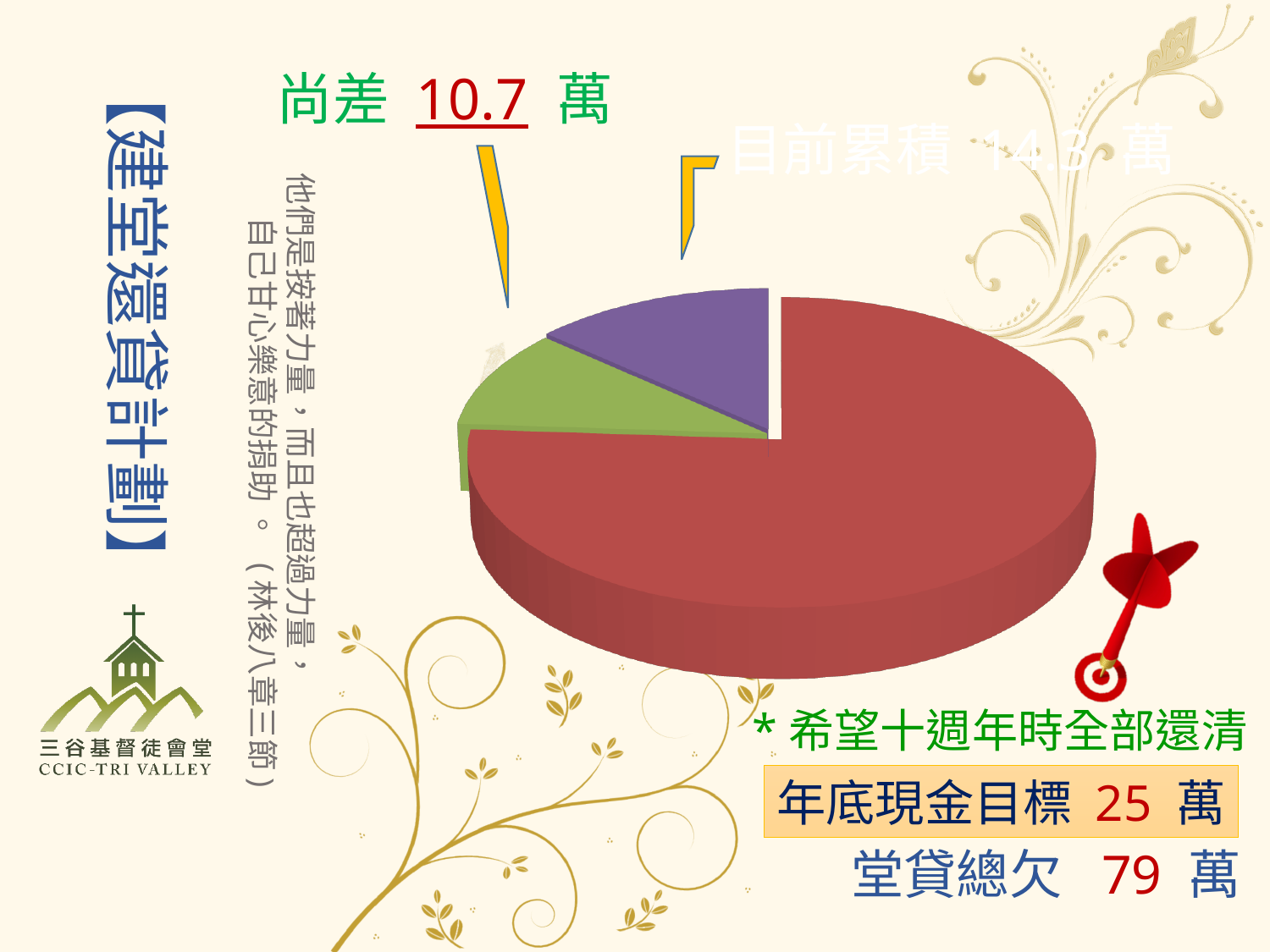
What is the 堂貸總欠 (total church loan owed) shown on the slide? 79 萬 What is the 年底現金目標 (year-end cash target) shown on the slide? 25 萬 What kind of chart is shown on the slide? pie chart What is the difference between 目前累積 (14.3 萬) and 尚差 (10.7 萬)? 3.6 萬 Which is larger, 尚差 or 目前累積? 目前累積 Which slice of the pie chart is the smallest: red, green or purple? green How many slices does the pie chart have? 3 What colour is the pie slice that the 尚差 10.7 萬 callout points to? green What value is shown for 尚差 (the shortfall) on the slide? 10.7 萬 What value is shown for 目前累積 (currently accumulated) on the slide? 14.3 萬 What colour is the pie slice that the 目前累積 14.3 萬 callout points to? purple Which slice of the pie chart is the largest: red, green or purple? red